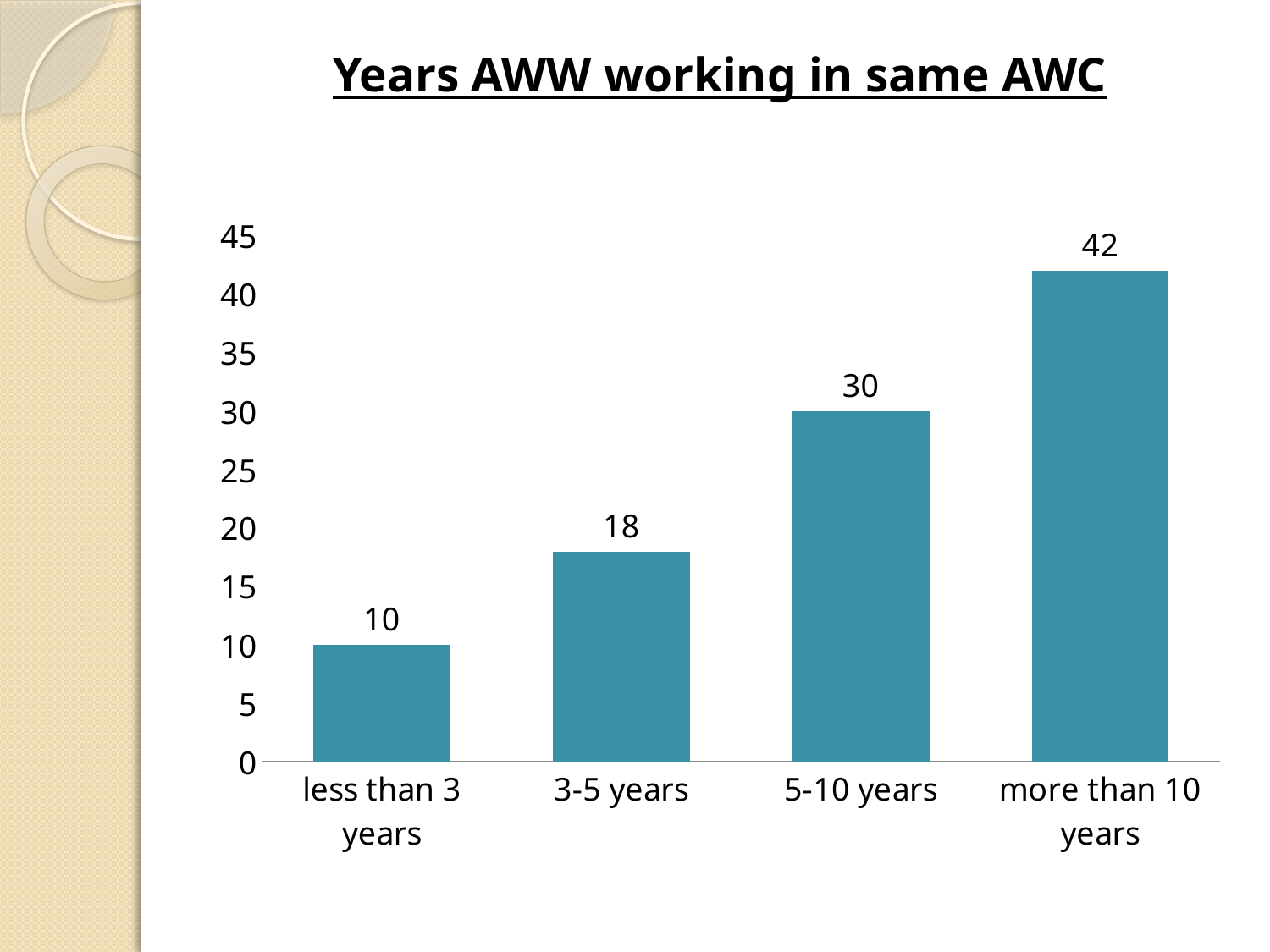
Which category has the highest value? more than 10 years What is the value for "less than 3 years"? 10 What kind of chart is shown on the slide? bar chart Do the values rise or fall from left to right along the x axis? rise What is the value for "3-5 years"? 18 What is the difference between the values for "5-10 years" and "3-5 years"? 12 Which is larger, the value for "5-10 years" or the value for "more than 10 years"? more than 10 years Is the value for "5-10 years" greater or less than 25? greater What is the title of the chart? Years AWW working in same AWC What is the value for "more than 10 years"? 42 Which category has the lowest value? less than 3 years How many categories are shown on the x axis? 4